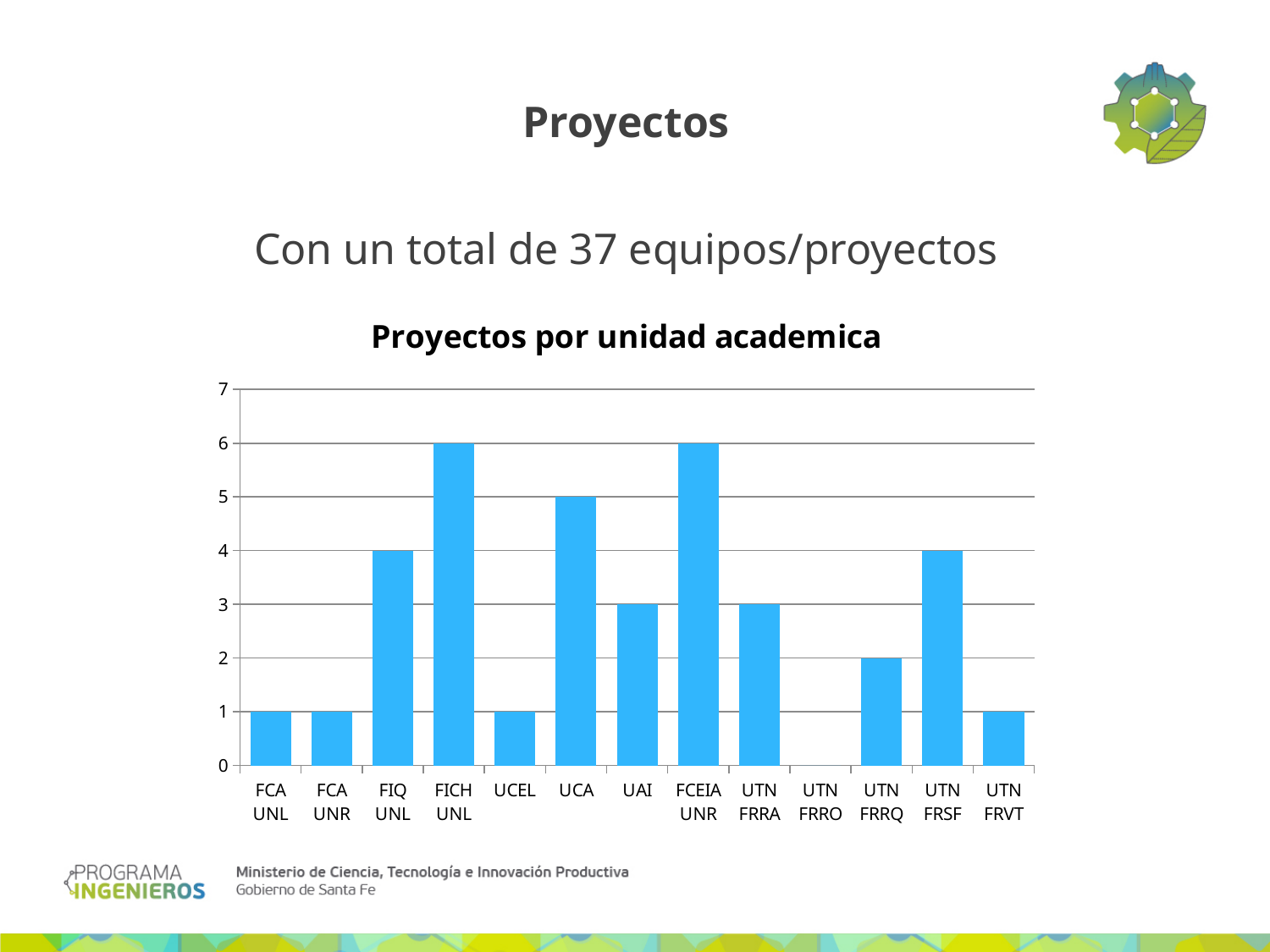
How many academic units (categories) are shown on the x axis of the chart? 13 How many projects does UTN FRRQ have according to the chart? 2 How many projects does UCA have according to the chart? 5 What is the difference between the number of projects for FCEIA UNR and UAI? 3 What is the title of the chart? Proyectos por unidad academica Which academic unit has the lowest number of projects in the chart? UTN FRRO Is the value for UCA greater or less than 4? greater How many projects does UTN FRSF have according to the chart? 4 What is the total number of equipos/proyectos stated on the slide? 37 What kind of chart is shown on the slide? bar chart How many projects does FICH UNL have according to the chart? 6 Which has more projects, FIQ UNL or UTN FRRA? FIQ UNL